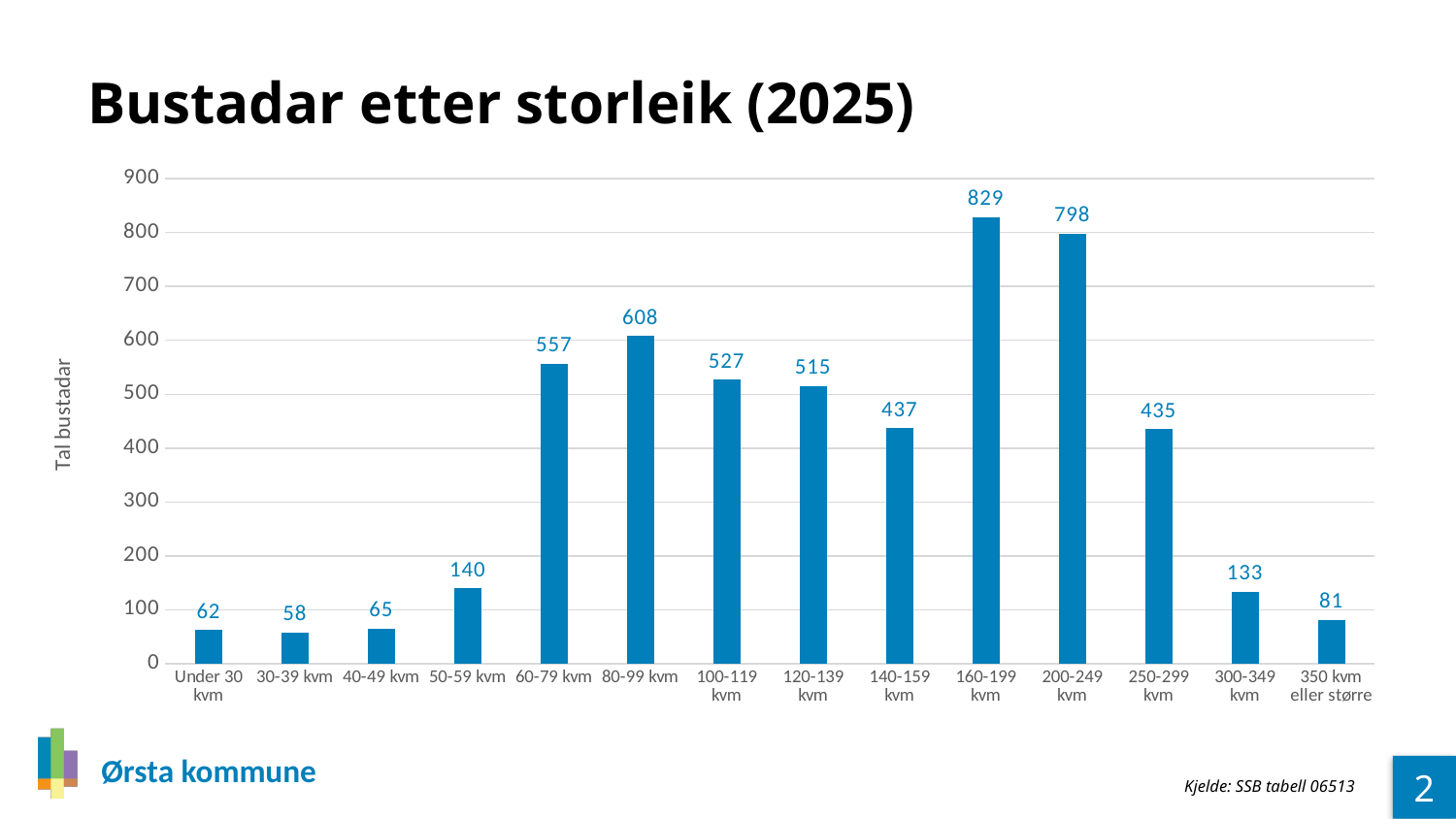
Which category has the lowest value? 30-39 kvm How many categories are shown on the x axis? 14 How many dwellings are shown for the 50-59 kvm category? 140 Is the value for 140-159 kvm greater or less than 400? greater What kind of chart is shown on the slide? Bar chart What is the difference between the values for 160-199 kvm and 200-249 kvm? 31 What is the value for the 350 kvm eller større category? 81 What is the value for the 160-199 kvm category? 829 Which category has the highest value? 160-199 kvm What is the difference between the values for 80-99 kvm and 60-79 kvm? 51 Which is larger, the value for 100-119 kvm or the value for 120-139 kvm? 100-119 kvm What is the title of the y axis? Tal bustadar